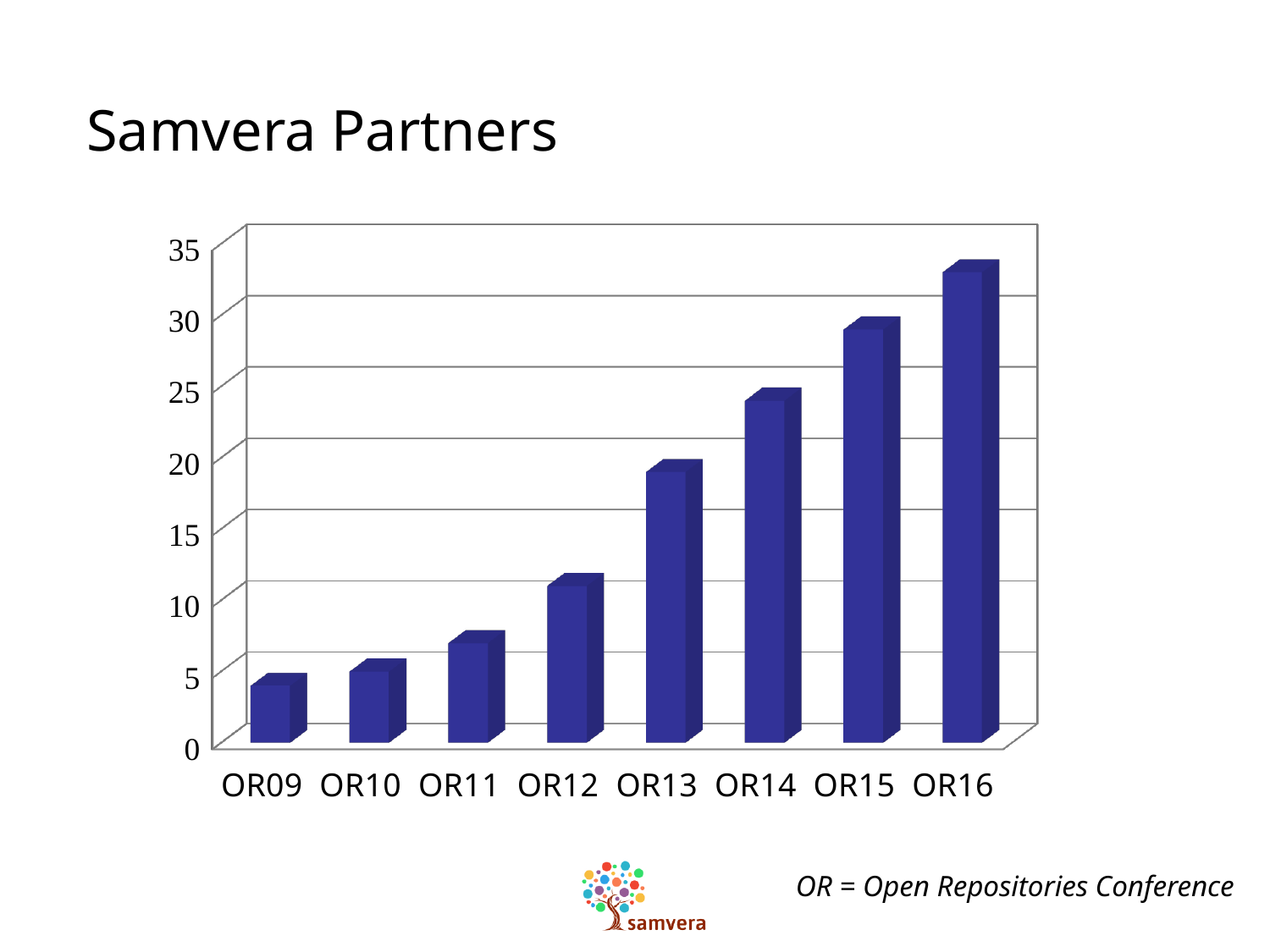
What kind of chart is shown on the slide? bar chart Is the value for OR16 greater or less than 30? greater How many categories are shown on the x axis of the chart? 8 Which category has the highest value in the chart? OR16 Which category has the lowest value in the chart? OR09 Is the value for OR13 greater or less than 25? less Is the value for OR15 greater or less than 25? greater Which is larger, the value for OR13 or the value for OR12? OR13 Do the values rise or fall from OR09 to OR16? rise What is the title of the chart on the slide? Samvera Partners